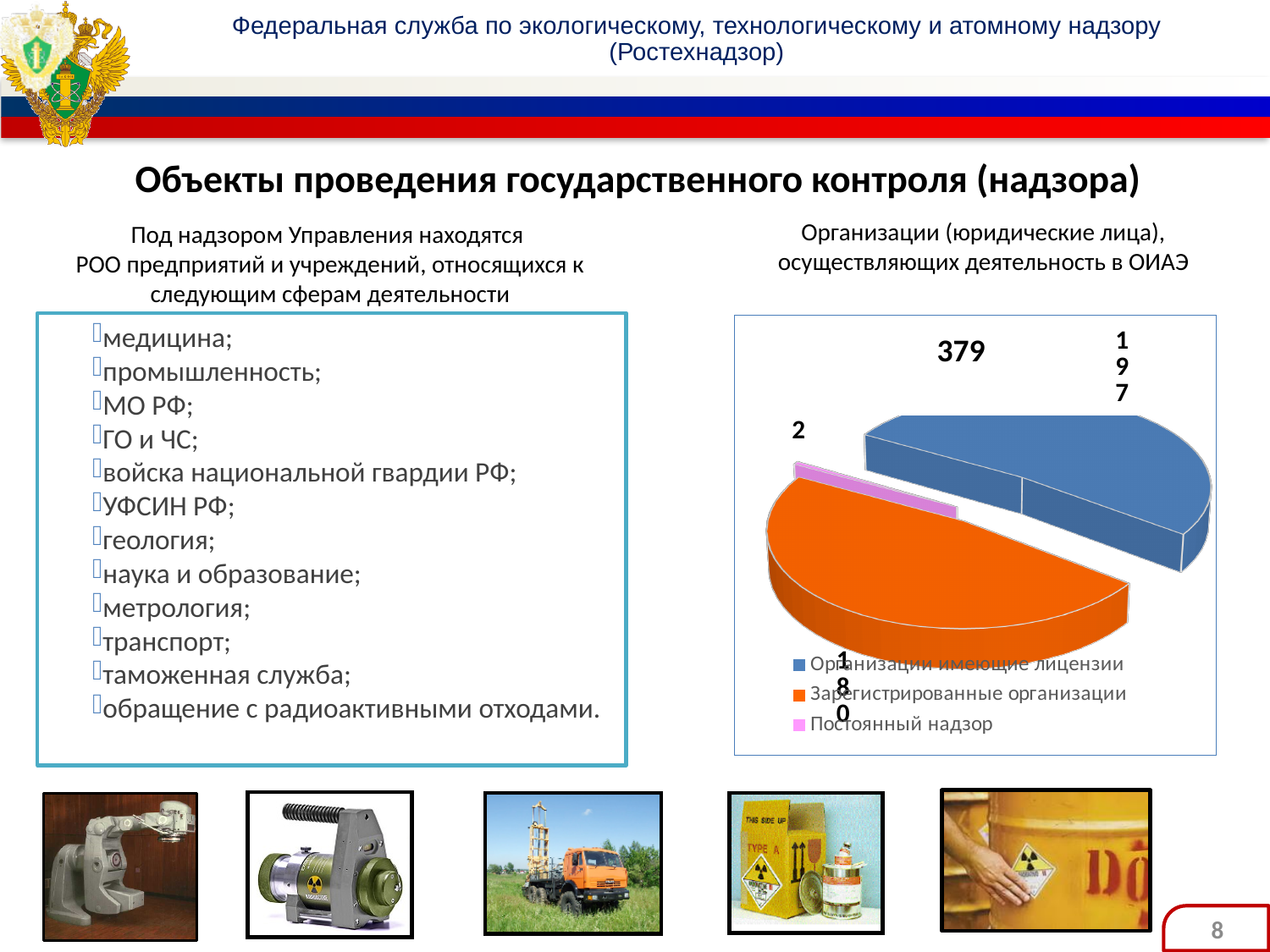
Which is larger in the pie chart: Организации имеющие лицензии or Зарегистрированные организации? Организации имеющие лицензии What is the difference between the values for Организации имеющие лицензии and Зарегистрированные организации? 17 What is the value for Зарегистрированные организации in the pie chart? 180 What kind of chart is shown on the slide? pie chart What is the value for Организации имеющие лицензии in the pie chart? 197 What colour is the slice for Постоянный надзор in the pie chart? pink What is the title above the pie chart? Организации (юридические лица), осуществляющих деятельность в ОИАЭ What is the total of all three values shown in the pie chart? 379 Which category has the largest slice in the pie chart? Организации имеющие лицензии What is the value for Постоянный надзор in the pie chart? 2 How many entries does the legend of the pie chart list? 3 Which category has the smallest slice in the pie chart? Постоянный надзор